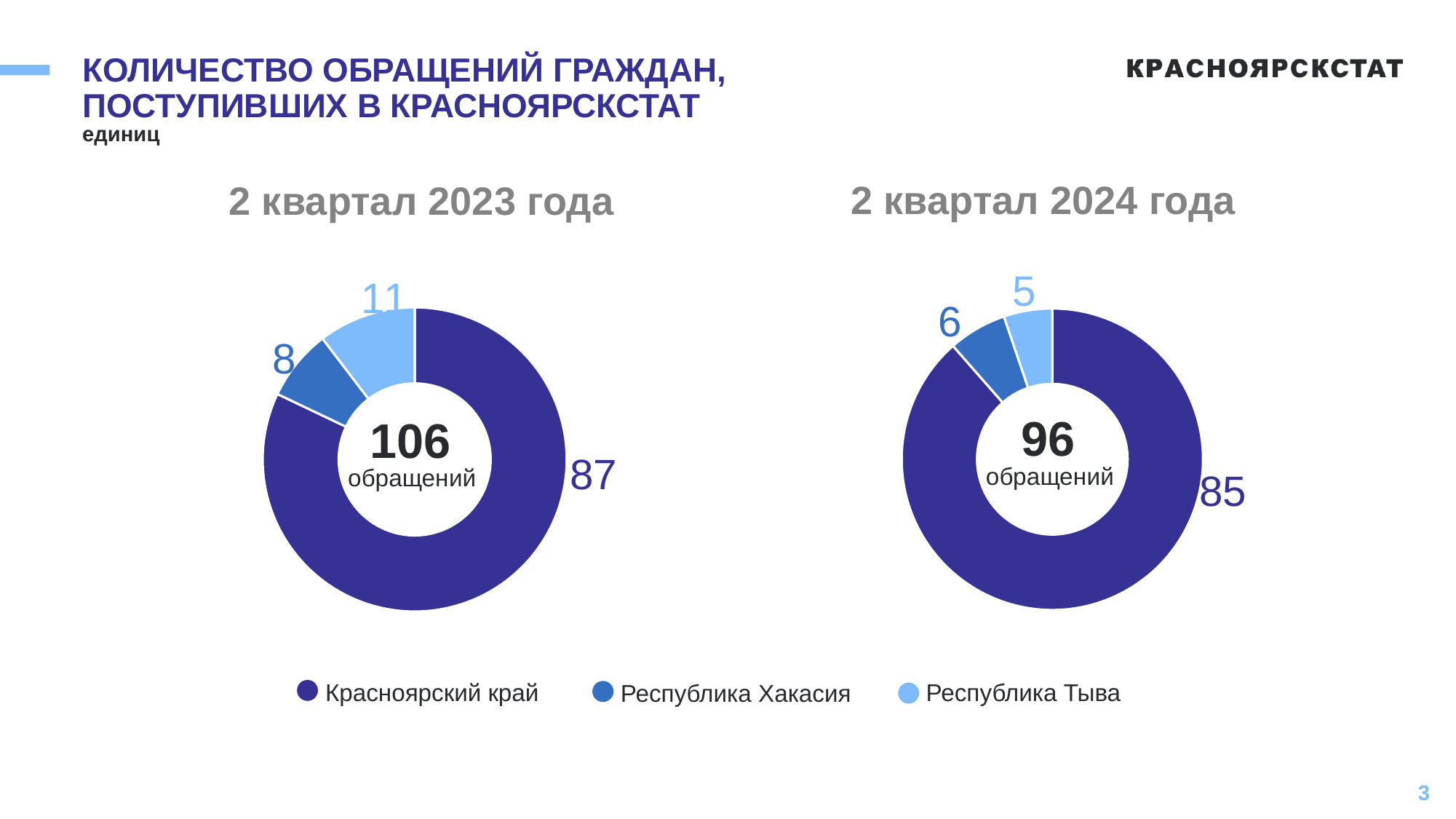
What is the total shown in the centre of the '2 квартал 2024 года' chart? 96 What is the difference between the Красноярский край values in the '2 квартал 2023 года' and '2 квартал 2024 года' charts? 2 In the '2 квартал 2023 года' chart, what is the value for Республика Тыва? 11 How many series does the legend list? 3 In the '2 квартал 2023 года' chart, what is the difference between Республика Тыва and Республика Хакасия? 3 In the '2 квартал 2023 года' chart, which category has the smallest slice? Республика Хакасия In the '2 квартал 2024 года' chart, which category has the largest slice? Красноярский край In the '2 квартал 2024 года' chart, what is the value for Республика Хакасия? 6 What kind of chart is the '2 квартал 2023 года' chart? Doughnut (pie) chart Which is larger: Республика Хакасия in the '2 квартал 2023 года' chart or Республика Хакасия in the '2 квартал 2024 года' chart? 2 квартал 2023 года In the '2 квартал 2023 года' chart, what is the value for Красноярский край? 87 In the '2 квартал 2024 года' chart, what is the value for Республика Тыва? 5